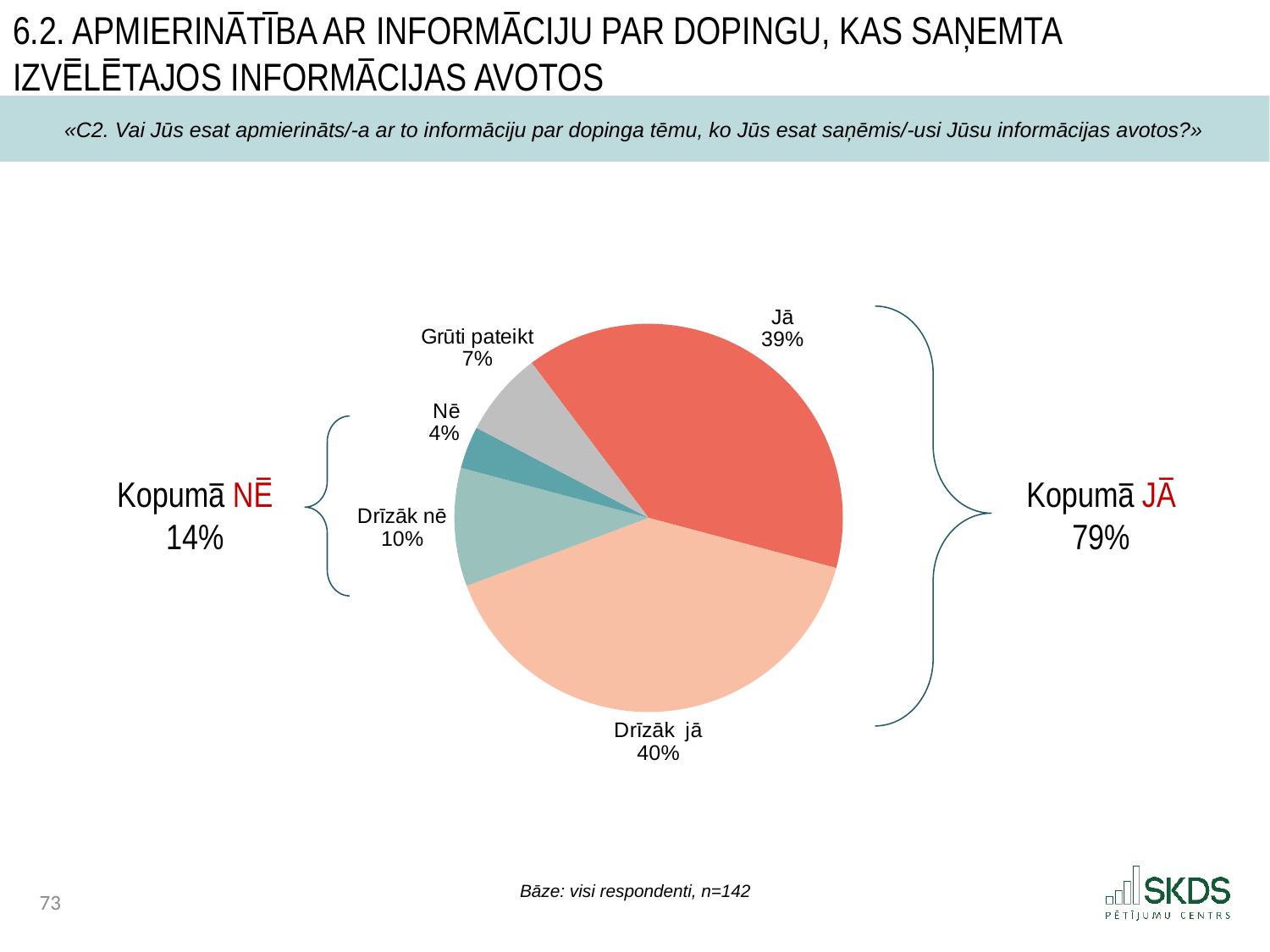
What is the combined share labelled "Kopumā JĀ"? 79% What share of respondents answered "Jā"? 39% What is the difference between the "Drīzāk jā" and "Drīzāk nē" shares? 30% What share of respondents answered "Nē"? 4% Which answer category has the smallest slice of the pie? Nē What is the combined share labelled "Kopumā NĒ"? 14% What share of respondents answered "Grūti pateikt"? 7% Which is larger, the share for "Grūti pateikt" or the share for "Nē"? Grūti pateikt What share of respondents answered "Drīzāk nē"? 10% How many slices does the pie chart have? 5 What kind of chart is shown on the slide? pie chart What share of respondents answered "Drīzāk jā"? 40%